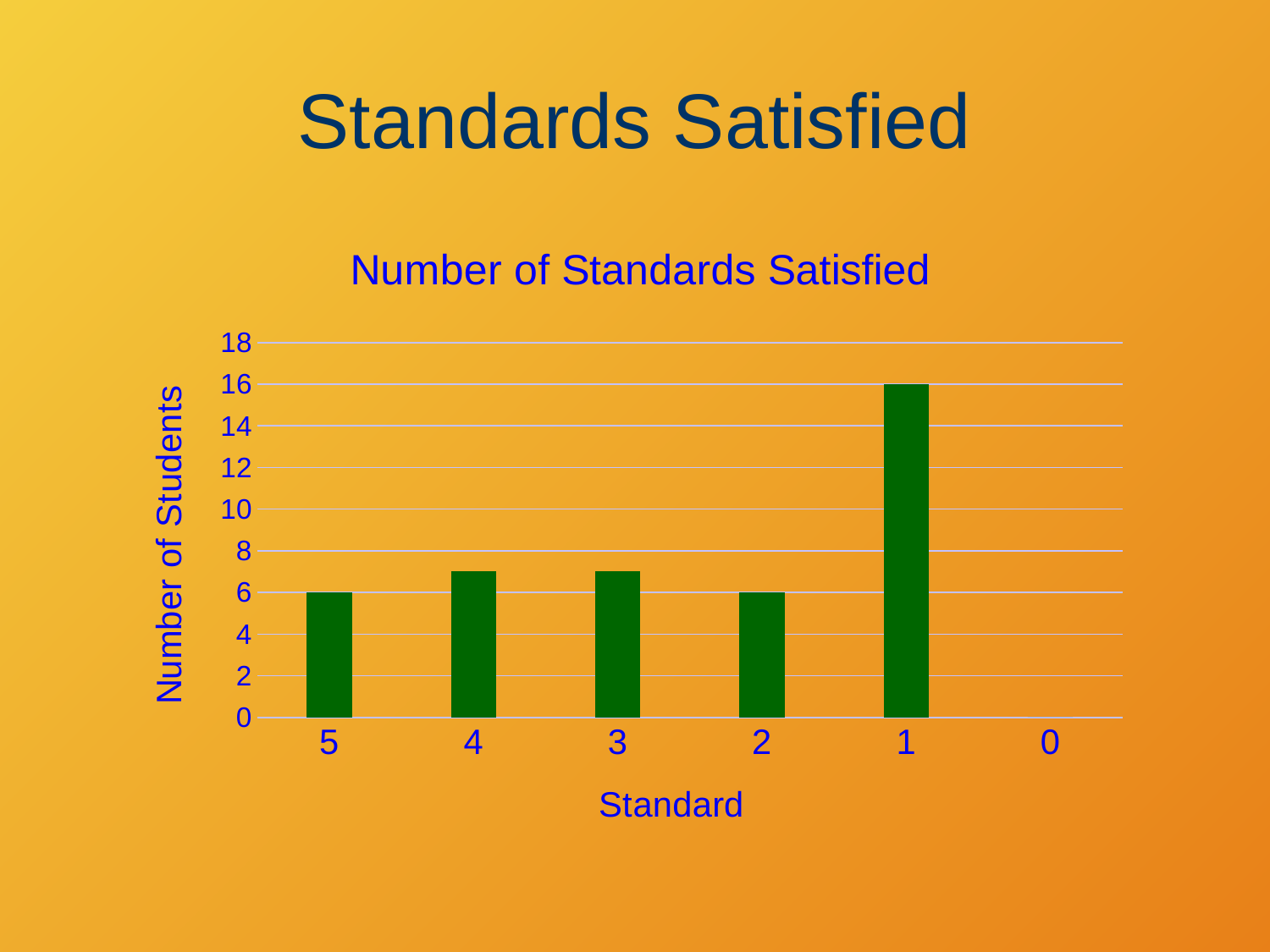
How many students satisfied standard 5? 6 What type of chart is shown on the slide? Bar chart What is the label on the vertical axis of the chart? Number of Students What is the difference between the number of students for standard 1 and standard 5? 10 Which standard has the tallest bar? 1 How many standard categories are shown on the x axis? 6 How many students satisfied standard 2? 6 Is the value for standard 4 greater or less than 8? less Which has more students, standard 1 or standard 2? Standard 1 How many students satisfied standard 1? 16 What is the title of the chart? Number of Standards Satisfied Is the value for standard 3 greater or less than 6? greater